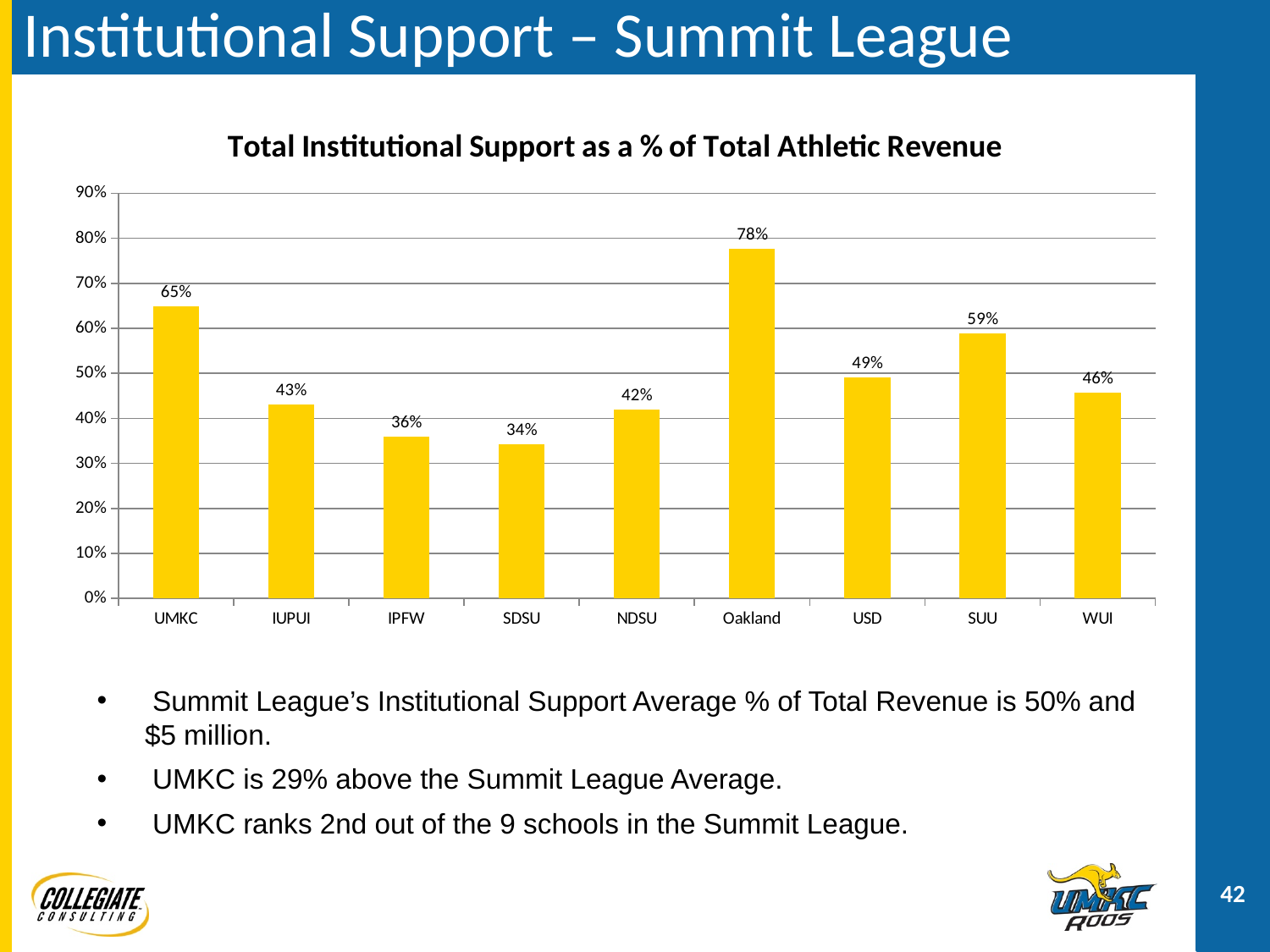
Is the value for SUU greater or less than 50%? greater Which is larger, the value for USD or the value for WUI? USD What is the value for Oakland? 78% What is the value for UMKC? 65% What is the difference between IUPUI and IPFW? 7% What is the difference between Oakland and UMKC? 13% How many schools are shown on the chart? 9 Which school has the highest value? Oakland Which school has the lowest value? SDSU What kind of chart is shown? bar chart What is the value for SDSU? 34% What is the title of the chart? Total Institutional Support as a % of Total Athletic Revenue